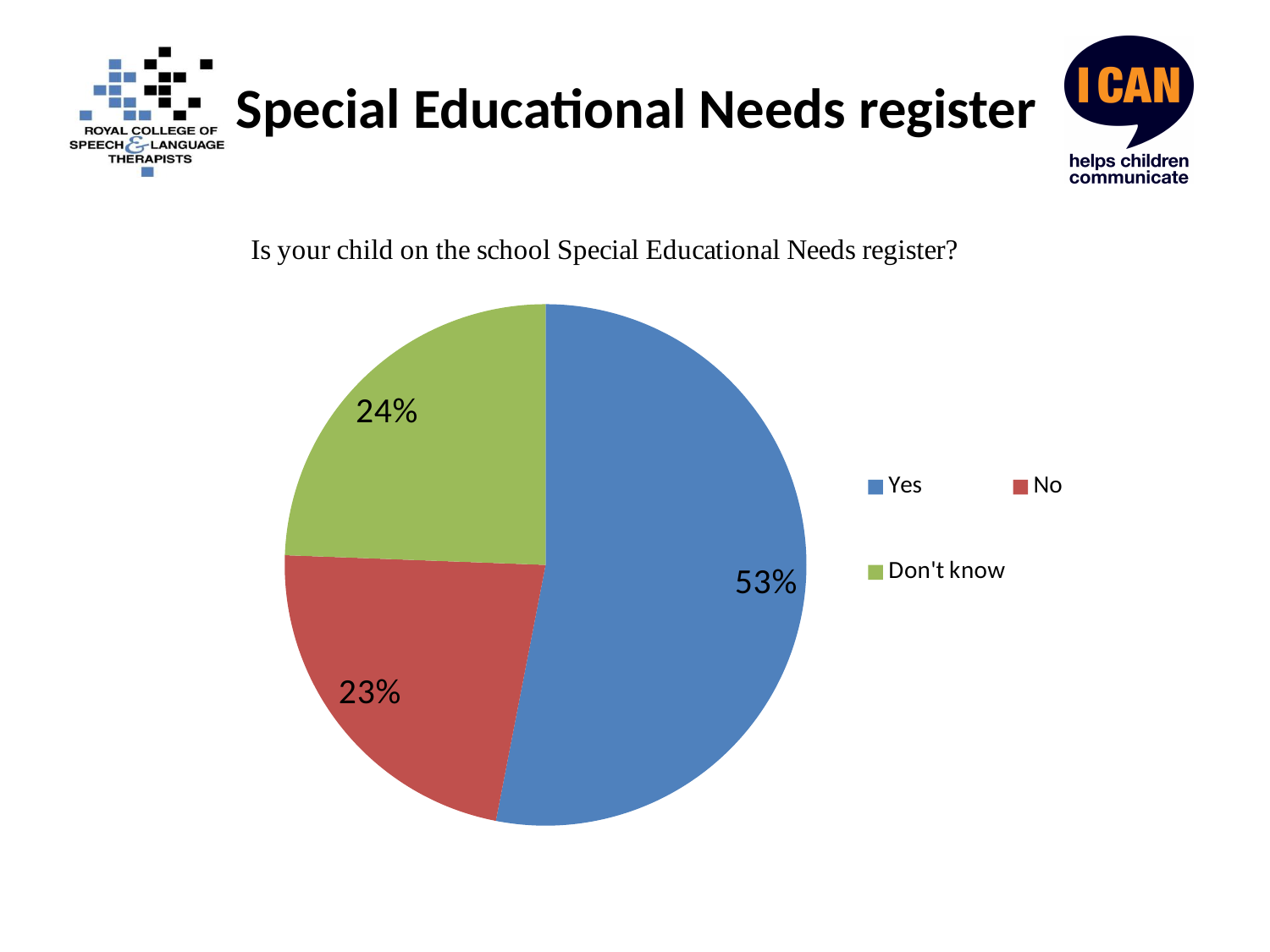
How many slices does the pie chart have? 3 What colour is the "Don't know" slice? green What percentage of respondents answered "Yes"? 53% How many entries does the legend list? 3 What question is the pie chart answering, as shown in its title? Is your child on the school Special Educational Needs register? What percentage of respondents answered "No"? 23% What type of chart is shown on the slide? pie chart Which is larger, the "Yes" slice or the "Don't know" slice? Yes What percentage of respondents answered "Don't know"? 24% Which response has the largest share of the pie? Yes What is the difference in percentage points between the "Yes" and "No" slices? 30 Which response has the smallest share of the pie? No